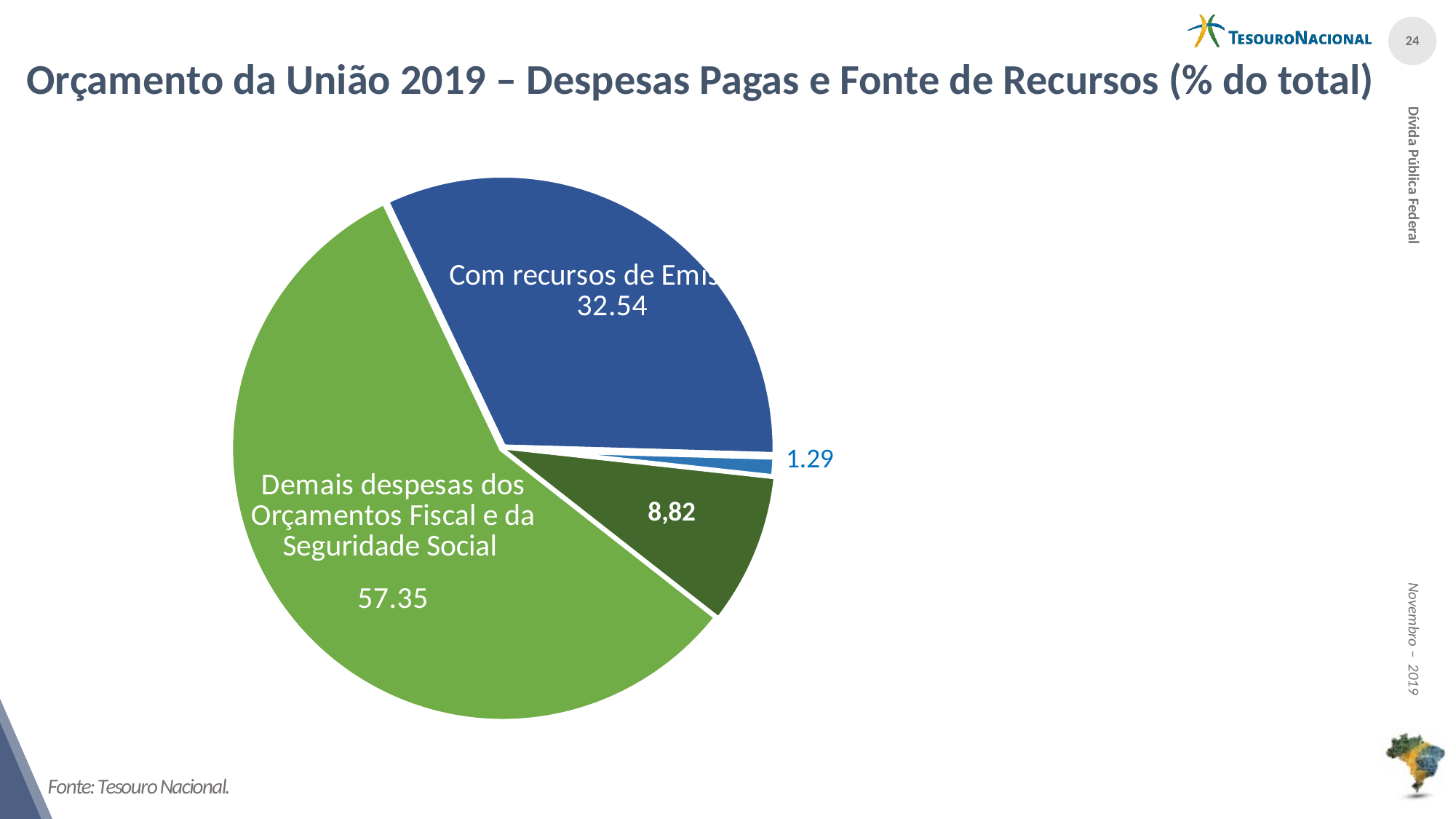
What is the value of the smallest slice in the pie chart? 1.29 What value is printed on the dark green slice of the pie chart? 8,82 Which slice of the pie chart is the largest? Demais despesas dos Orçamentos Fiscal e da Seguridade Social What value is printed on the dark blue slice of the pie chart? 32.54 What is the title of the slide containing the pie chart? Orçamento da União 2019 – Despesas Pagas e Fonte de Recursos (% do total) What kind of chart is shown on the slide? pie chart What is the value shown for the slice labelled "Demais despesas dos Orçamentos Fiscal e da Seguridade Social"? 57.35 What value is printed next to the smallest, light blue slice of the pie chart? 1.29 Which is larger: the dark blue slice or the dark green slice? the dark blue slice What is the difference between the value of the "Demais despesas dos Orçamentos Fiscal e da Seguridade Social" slice and the dark blue slice (32.54)? 24.81 What colour is the largest slice of the pie chart? green How many slices does the pie chart have? 4